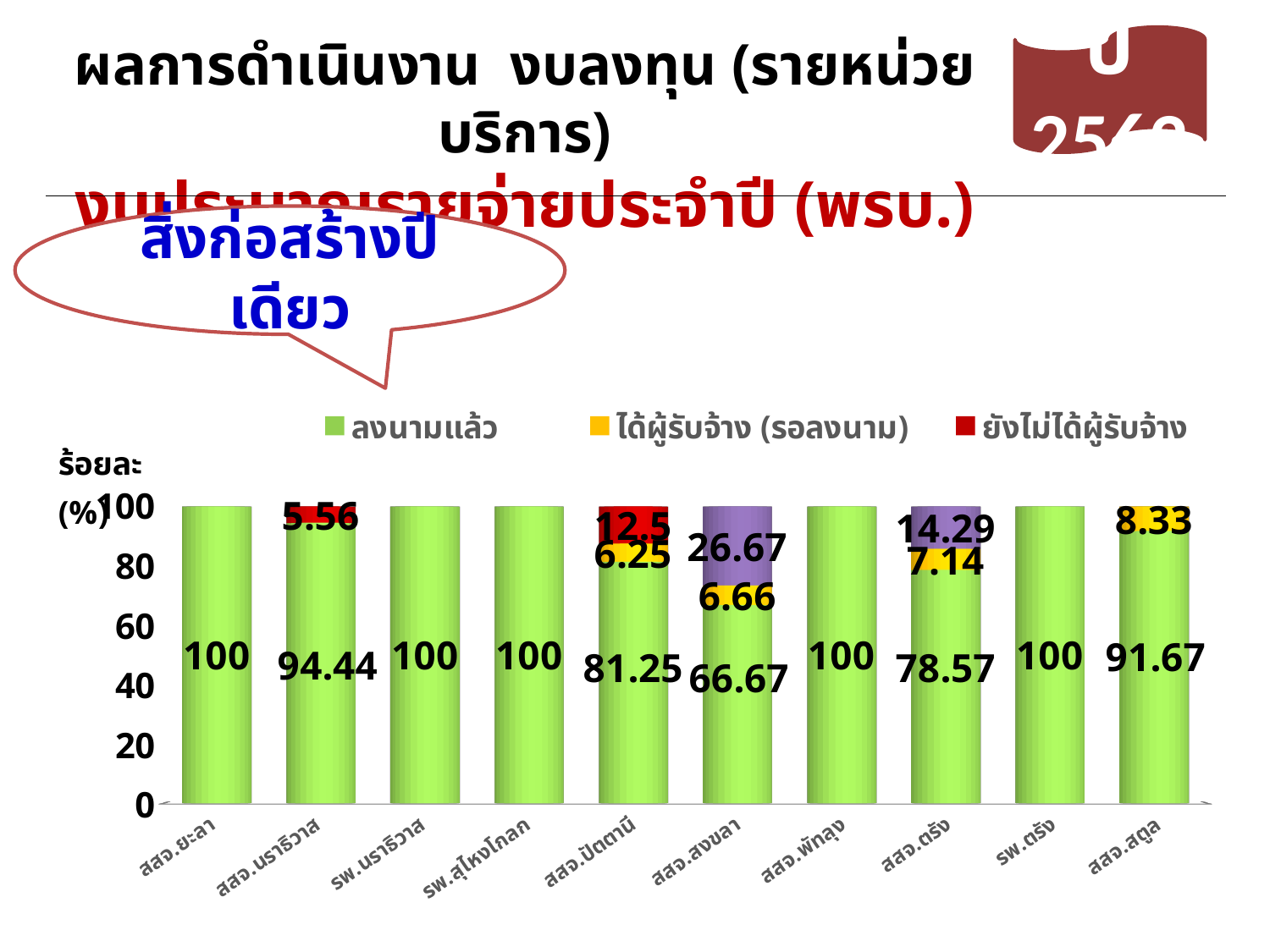
What kind of chart is shown on the slide? Stacked bar chart What is the value of ได้ผู้รับจ้าง (รอลงนาม) for สสจ.ปัตตานี? 6.25 What is the label on the vertical axis? ร้อยละ (%) How many categories are shown on the x axis? 10 What is the value of ลงนามแล้ว for สสจ.สงขลา? 66.67 What is the value of ได้ผู้รับจ้าง (รอลงนาม) for สสจ.สตูล? 8.33 What is the total of the stacked bar for สสจ.ปัตตานี? 100 How many series does the legend list? 3 Which has a larger ลงนามแล้ว value, สสจ.ปัตตานี or สสจ.ตรัง? สสจ.ปัตตานี Which category has the lowest value for ลงนามแล้ว? สสจ.สงขลา What is the difference between the ลงนามแล้ว values for สสจ.ยะลา and สสจ.นราธิวาส? 5.56 What is the value of ยังไม่ได้ผู้รับจ้าง for สสจ.นราธิวาส? 5.56